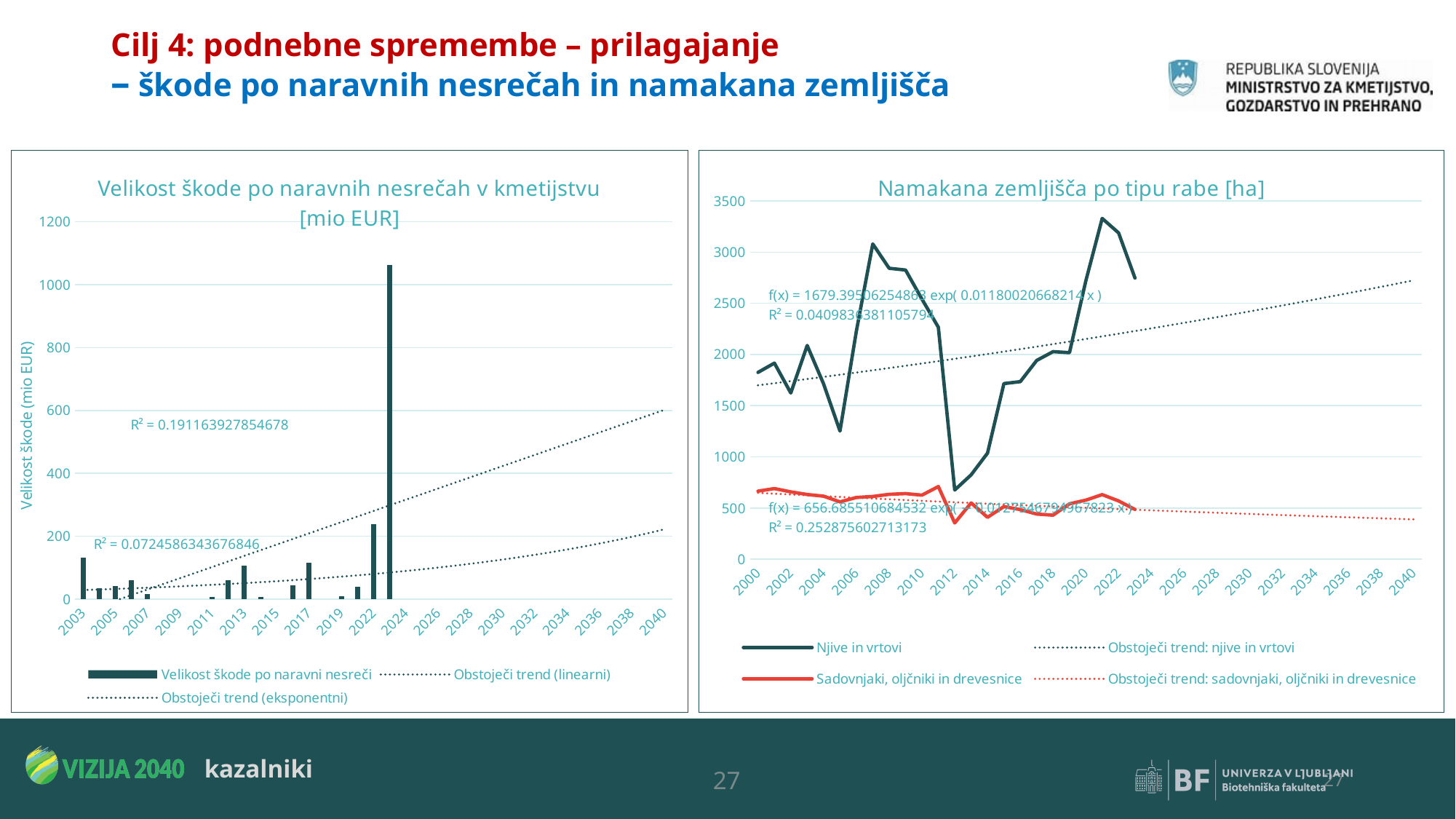
In the right chart, is the peak value of 'Njive in vrtovi' greater or less than 3000? greater What kind of chart is the left chart, 'Velikost škode po naravnih nesrečah v kmetijstvu [mio EUR]'? bar chart What kind of chart is the right chart, 'Namakana zemljišča po tipu rabe [ha]'? line chart In the right chart, is the value of 'Sadovnjaki, oljčniki in drevesnice' in 2000 greater or less than 1000? less How many entries does the legend of the left chart list? 3 In the right chart, which series has higher values overall, 'Njive in vrtovi' or 'Sadovnjaki, oljčniki in drevesnice'? Njive in vrtovi In the right chart, does the dotted trend line 'Obstoječi trend: njive in vrtovi' rise or fall towards 2040? rise In the right chart, does the red dotted trend line 'Obstoječi trend: sadovnjaki, oljčniki in drevesnice' rise or fall towards 2040? fall In the left chart, is the tallest bar greater or less than 1000? greater How many entries does the legend of the right chart list? 4 What is the y-axis label of the left chart? Velikost škode (mio EUR)